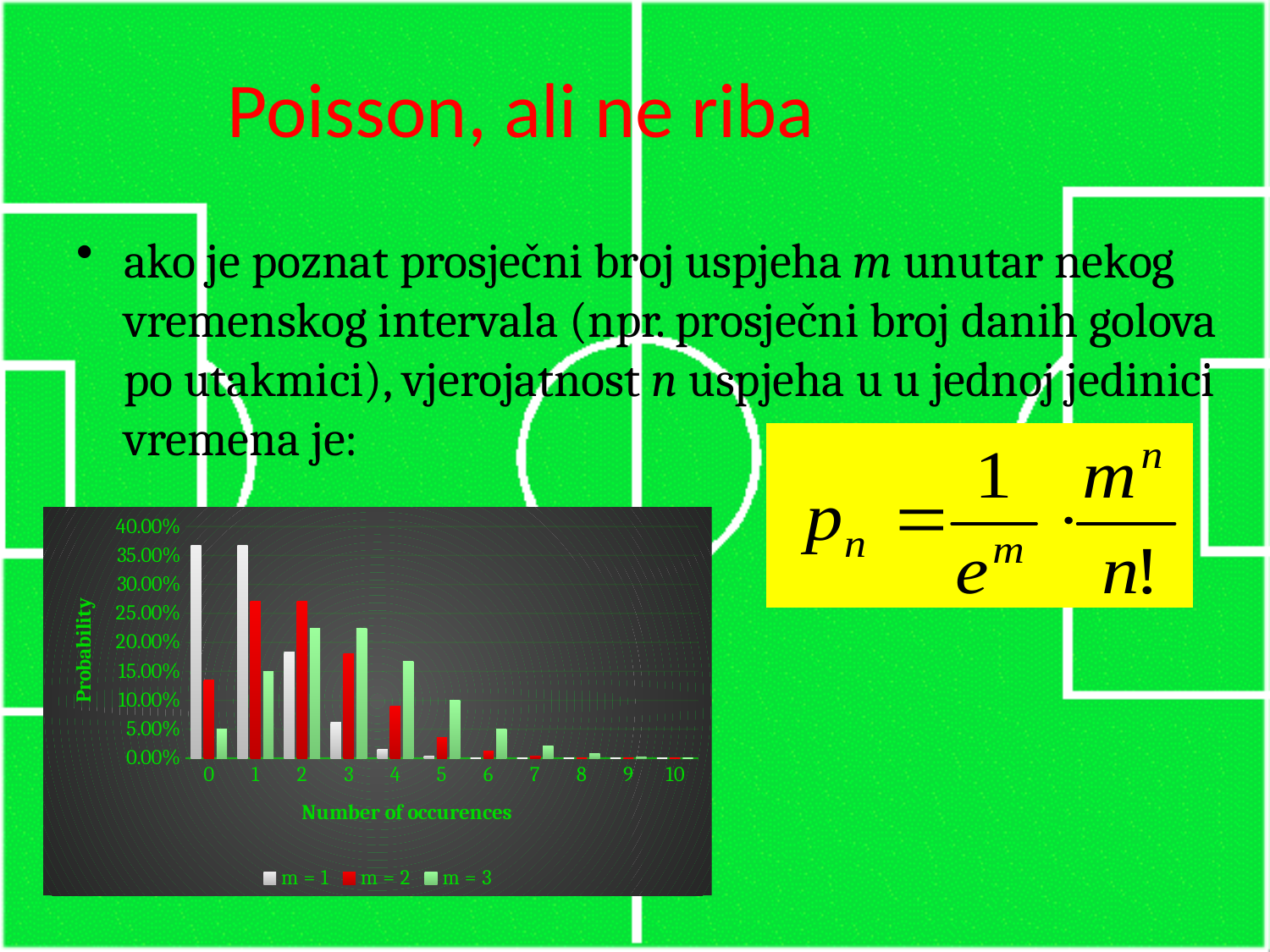
Is the value for m = 2 at 1 occurrence greater or less than 25.00%? greater How many series does the chart legend list? 3 How many categories are shown on the x axis of the chart? 11 What kind of chart is shown on the slide? bar chart Is the value for m = 3 at 0 occurrences greater or less than 10.00%? less Which series has the highest value at 0 occurrences? m = 1 Is the value for m = 1 at 3 occurrences greater or less than 10.00%? less At 2 occurrences, which is larger: the value for m = 2 or the value for m = 3? m = 2 Which series has the highest value at 5 occurrences? m = 3 What is the title of the vertical axis of the chart? Probability What is the title of the horizontal axis of the chart? Number of occurences